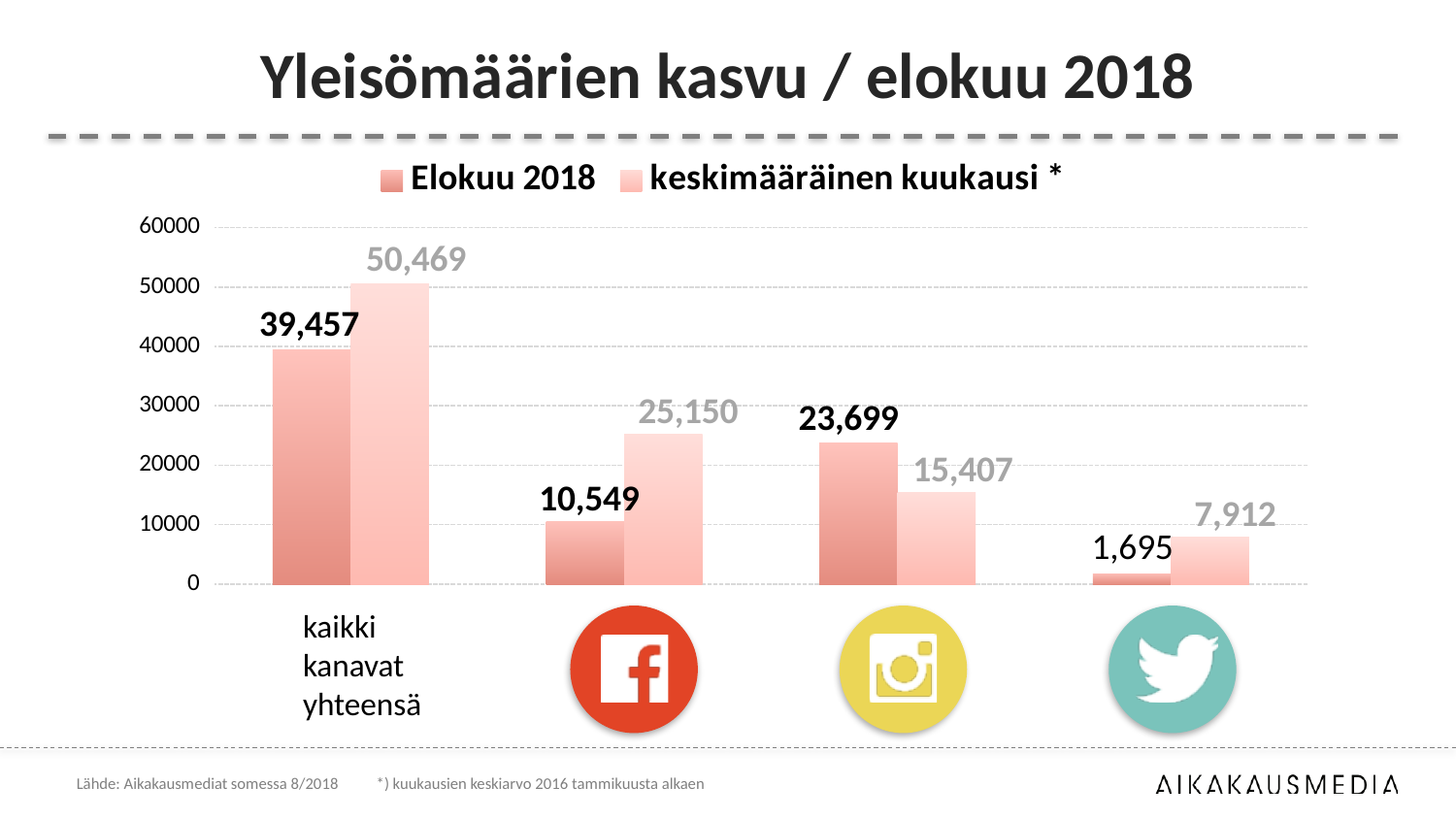
What is the Elokuu 2018 value for the Twitter category? 1,695 What is the difference between the keskimääräinen kuukausi and Elokuu 2018 values for the Facebook category? 14,601 Which category has the highest keskimääräinen kuukausi value? kaikki kanavat yhteensä What is the Elokuu 2018 value for kaikki kanavat yhteensä? 39,457 What is the Elokuu 2018 value for the Facebook category? 10,549 What is the keskimääräinen kuukausi value for the Instagram category? 15,407 What is the keskimääräinen kuukausi value for kaikki kanavat yhteensä? 50,469 For the Instagram category, which is larger: the Elokuu 2018 value or the keskimääräinen kuukausi value? Elokuu 2018 How many categories are shown on the x axis? 4 Which category has the lowest Elokuu 2018 value? Twitter How many series does the legend list? 2 What kind of chart is shown on the slide? Bar chart